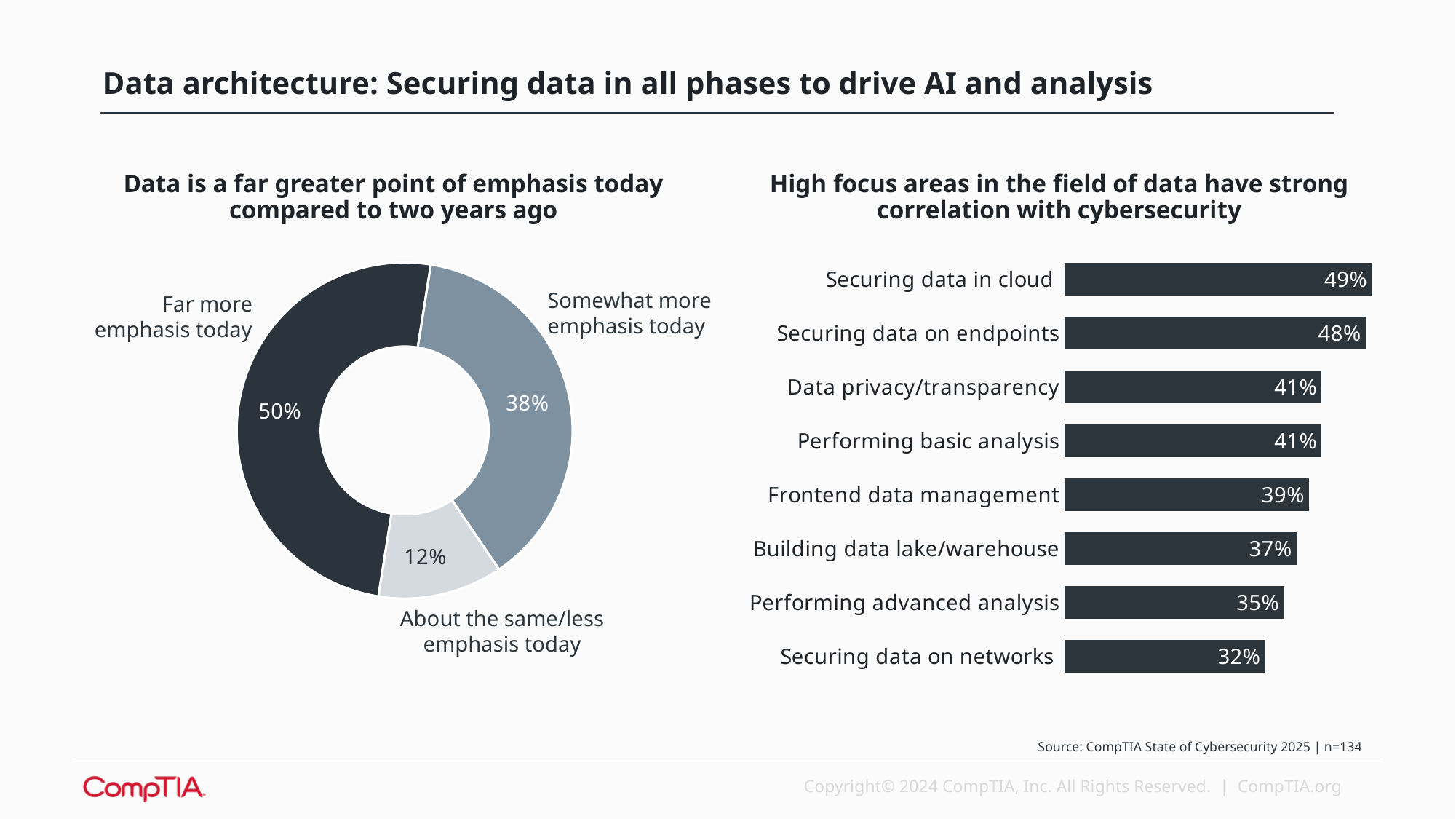
In the left chart (Data is a far greater point of emphasis today compared to two years ago), how many categories are shown? 3 In the left chart (Data is a far greater point of emphasis today compared to two years ago), which category has the smallest share? About the same/less emphasis today What kind of chart is the left chart (Data is a far greater point of emphasis today compared to two years ago)? Doughnut (pie) chart In the left chart (Data is a far greater point of emphasis today compared to two years ago), what share is labelled for 'About the same/less emphasis today'? 12% In the right chart (High focus areas in the field of data have strong correlation with cybersecurity), what is the value for 'Securing data on endpoints'? 48% In the right chart (High focus areas in the field of data have strong correlation with cybersecurity), what is the value for 'Building data lake/warehouse'? 37% In the left chart (Data is a far greater point of emphasis today compared to two years ago), what share is labelled for 'Far more emphasis today'? 50% In the right chart (High focus areas in the field of data have strong correlation with cybersecurity), which is larger: 'Frontend data management' or 'Performing advanced analysis'? Frontend data management In the right chart (High focus areas in the field of data have strong correlation with cybersecurity), how many categories are shown? 8 In the right chart (High focus areas in the field of data have strong correlation with cybersecurity), what is the difference between 'Securing data in cloud' and 'Securing data on networks'? 17% In the right chart (High focus areas in the field of data have strong correlation with cybersecurity), which category has the highest value? Securing data in cloud In the right chart (High focus areas in the field of data have strong correlation with cybersecurity), which category has the lowest value? Securing data on networks